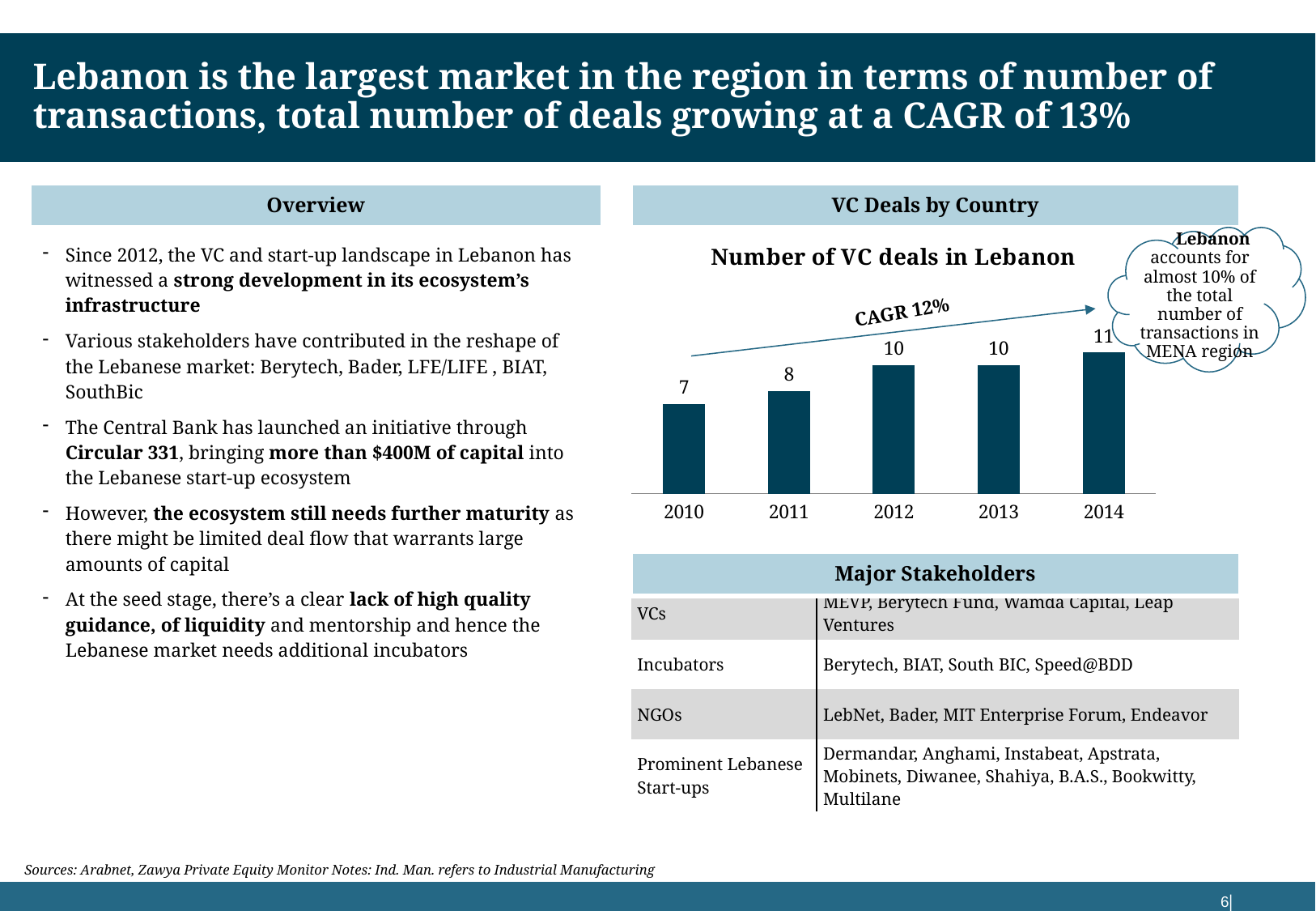
How many years are shown in the Number of VC deals in Lebanon chart? 5 What is the difference in the number of VC deals in Lebanon between 2014 and 2010? 4 What CAGR is annotated on the Number of VC deals in Lebanon chart? CAGR 12% Which year has the highest number of VC deals in Lebanon? 2014 Do the number of VC deals in Lebanon generally rise or fall from 2010 to 2014? Rise What type of chart is used to show the number of VC deals in Lebanon? Bar chart Which year has the lowest number of VC deals in Lebanon? 2010 What is the title of the chart on the slide? Number of VC deals in Lebanon What is the number of VC deals in Lebanon in 2014? 11 Which year had more VC deals in Lebanon, 2011 or 2013? 2013 What is the number of VC deals in Lebanon in 2012? 10 What is the number of VC deals in Lebanon in 2010? 7